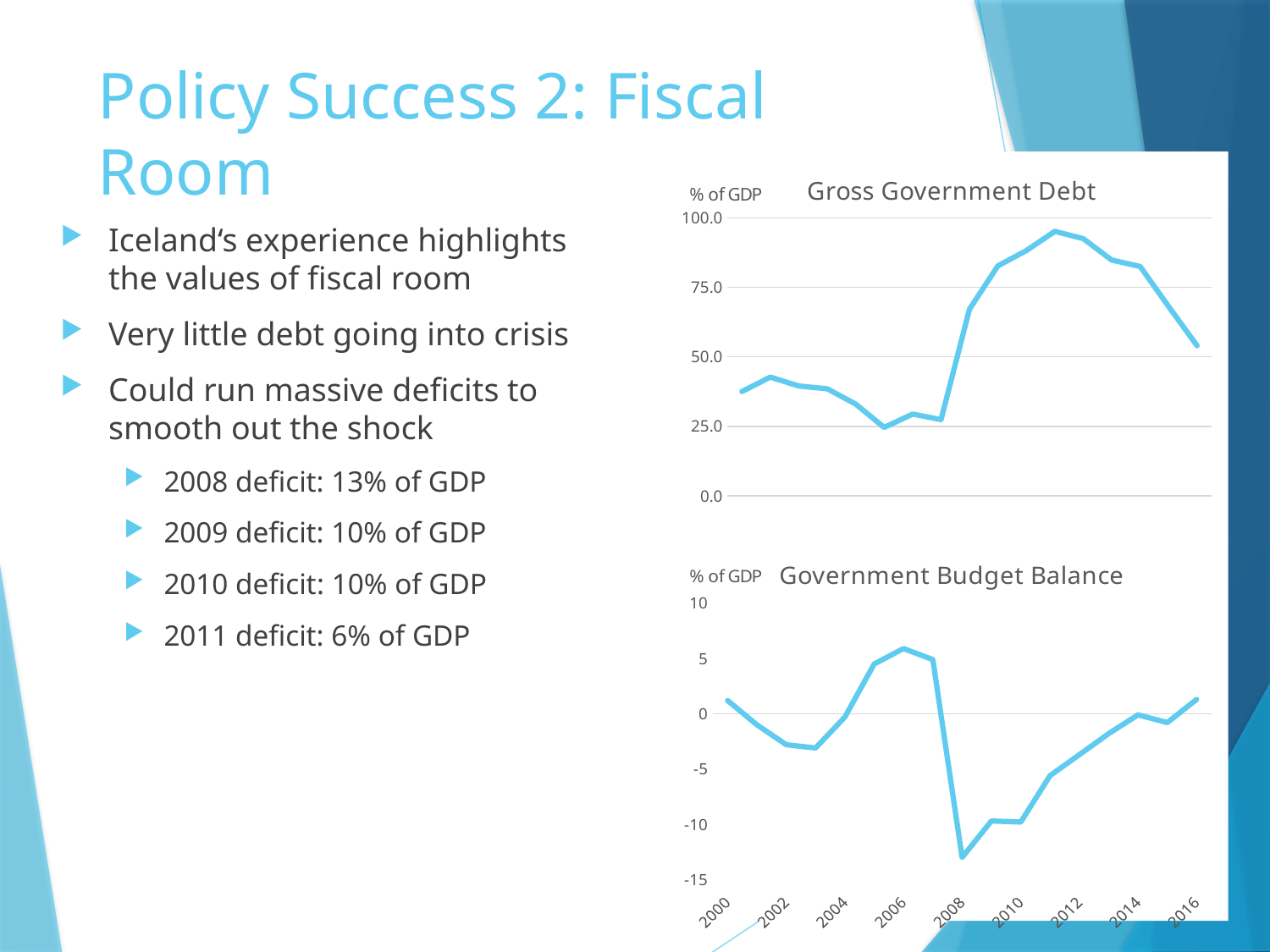
In the Gross Government Debt chart, does the line overall rise or fall from its first point to its last point? rise In the Government Budget Balance chart, which year has the lowest value? 2008 What kind of chart is the Gross Government Debt chart? line chart What kind of chart is the Government Budget Balance chart? line chart In the Government Budget Balance chart, is the value for 2002 greater or less than 0? less In the Government Budget Balance chart, is the value for 2012 greater or less than 0? less How many year labels are shown on the x axis of the Government Budget Balance chart? 9 In the Gross Government Debt chart, is the peak value greater or less than 75.0? greater In the Government Budget Balance chart, which year has the highest value? 2006 In the Government Budget Balance chart, which is larger, the value for 2006 or the value for 2008? 2006